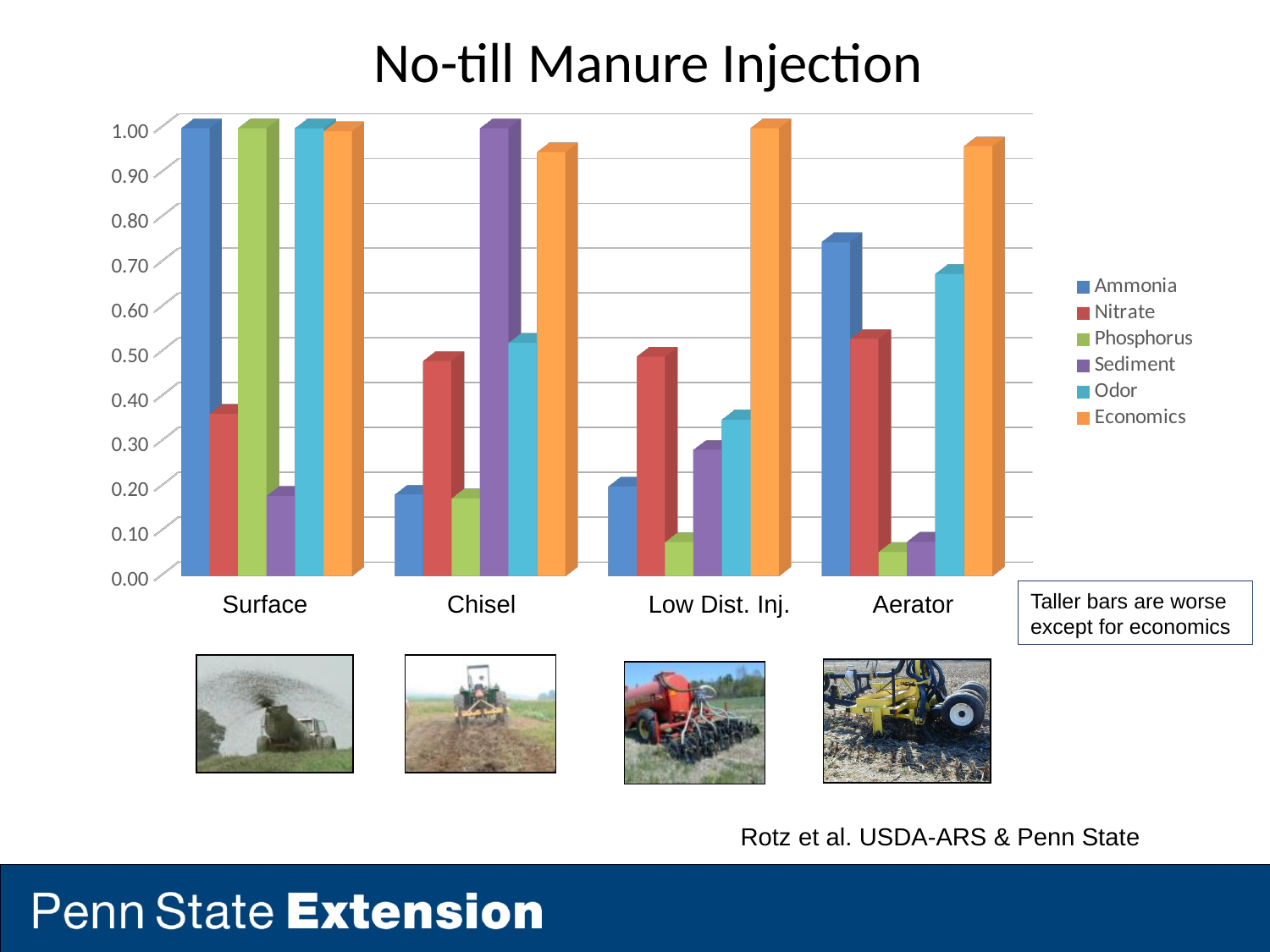
Which series is shown in orange in the chart? Economics Is the Nitrate value for Chisel greater or less than 0.40? greater Is the Phosphorus value for Low Dist. Inj. greater or less than 0.10? less Which category has the lowest Sediment value? Aerator How many series does the chart's legend list? 6 Is the Odor value for Chisel greater or less than 0.40? greater Which category has the highest Ammonia value? Surface How many categories are shown along the x axis of the chart? 4 What is the title of the chart? No-till Manure Injection What kind of chart is shown on the slide? Bar chart Which has the larger Nitrate value, Surface or Aerator? Aerator